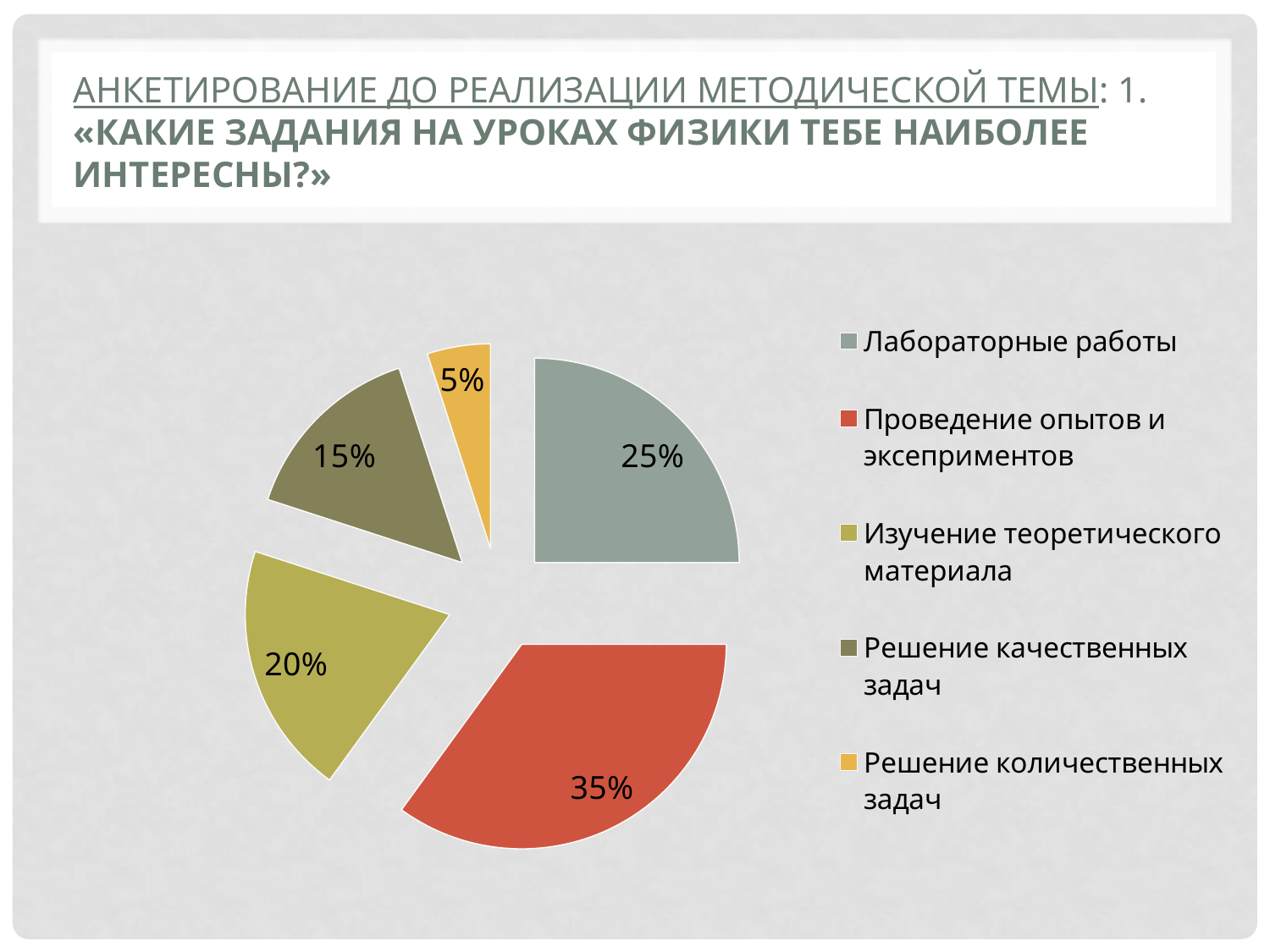
Which is larger: the share for Изучение теоретического материала or the share for Решение качественных задач? Изучение теоретического материала What share of the pie is labelled for Проведение опытов и эксеприментов? 35% What share of the pie is labelled for Изучение теоретического материала? 20% What kind of chart is shown on the slide? Pie chart What colour is the slice for Решение количественных задач? Yellow Which category has the largest slice of the pie? Проведение опытов и эксеприментов What share of the pie is labelled for Решение качественных задач? 15% Which category has the smallest slice of the pie? Решение количественных задач What is the difference between the shares for Проведение опытов и эксеприментов and Лабораторные работы? 10% How many categories does the legend list? 5 What share of the pie is labelled for Лабораторные работы? 25% What share of the pie is labelled for Решение количественных задач? 5%